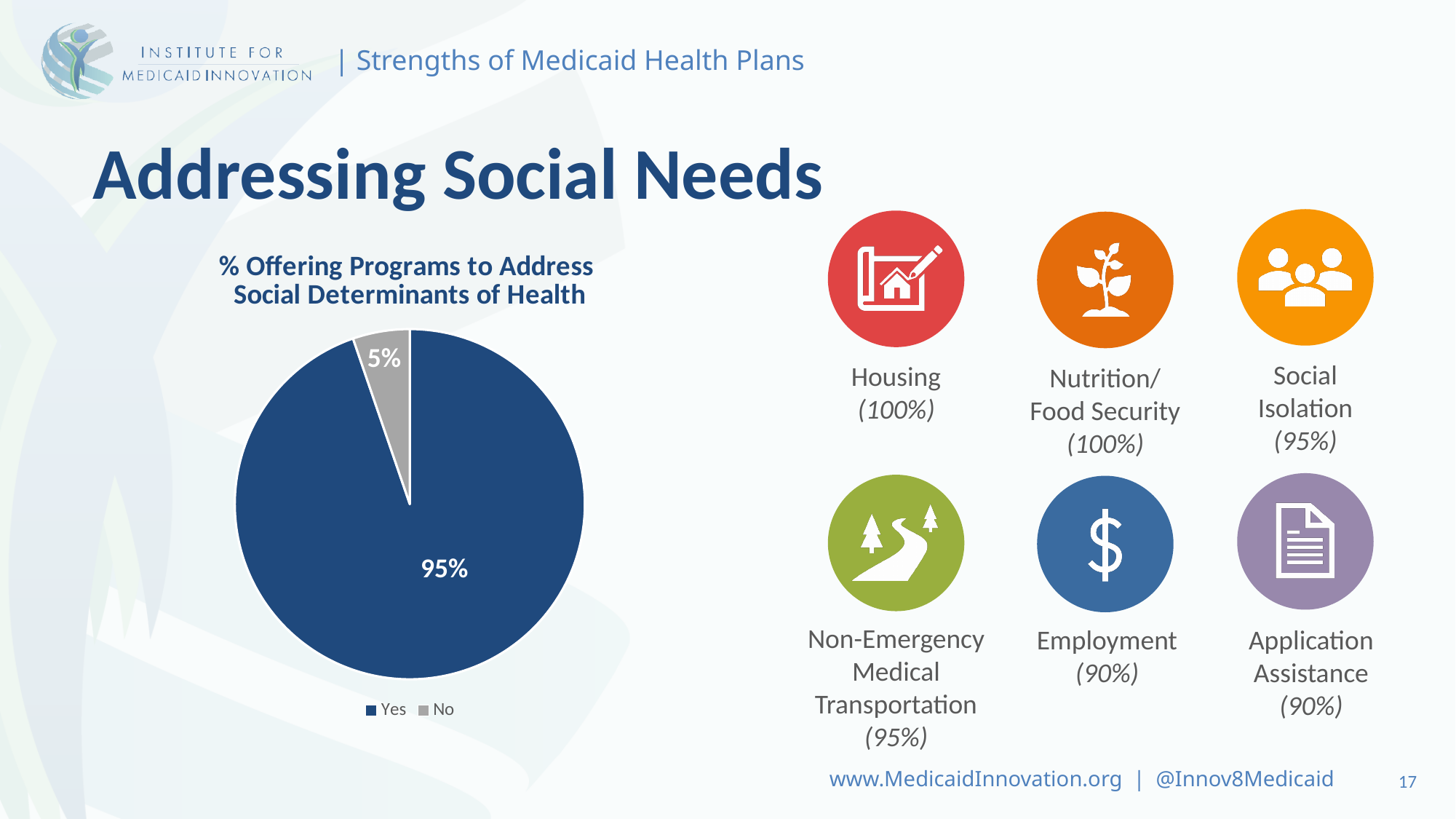
What kind of chart is shown on the slide? pie chart Which is larger in the pie chart, the "Yes" slice or the "No" slice? Yes How many entries does the pie chart's legend list? 2 What is the title of the pie chart? % Offering Programs to Address Social Determinants of Health What is the difference in percentage points between the "Yes" and "No" slices? 90 What share of the pie does the "Yes" slice represent? 95% What percentage of the pie chart is labelled "Yes"? 95% Which slice of the pie chart is the smallest? No Which slice of the pie chart is the largest? Yes How many slices does the pie chart have? 2 What colour is the "No" slice in the pie chart? grey What percentage of the pie chart is labelled "No"? 5%